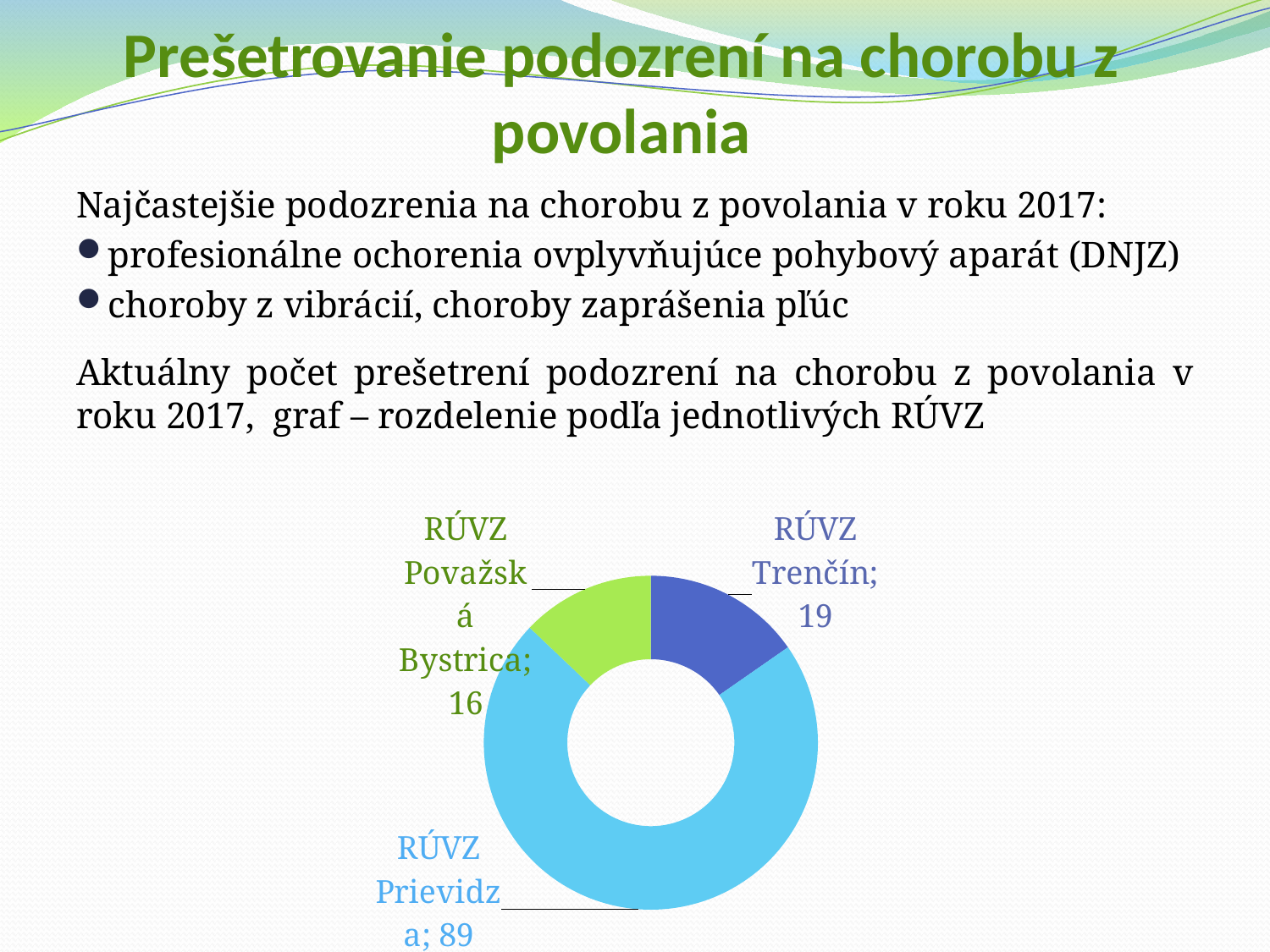
What is the value for RÚVZ Trenčín in the chart? 19 What is the value for RÚVZ Považská Bystrica in the chart? 16 What is the value for RÚVZ Prievidza in the chart? 89 How many categories (RÚVZ) are shown in the chart? 3 Which is larger, the value for RÚVZ Trenčín or the value for RÚVZ Považská Bystrica? RÚVZ Trenčín What colour is the segment for RÚVZ Považská Bystrica? Green What kind of chart is shown on the slide? Doughnut (pie) chart Which RÚVZ has the lowest value in the chart? RÚVZ Považská Bystrica What is the difference between the values for RÚVZ Prievidza and RÚVZ Trenčín? 70 What is the total of all values shown in the chart? 124 Which RÚVZ has the highest value in the chart? RÚVZ Prievidza What is the difference between the values for RÚVZ Trenčín and RÚVZ Považská Bystrica? 3